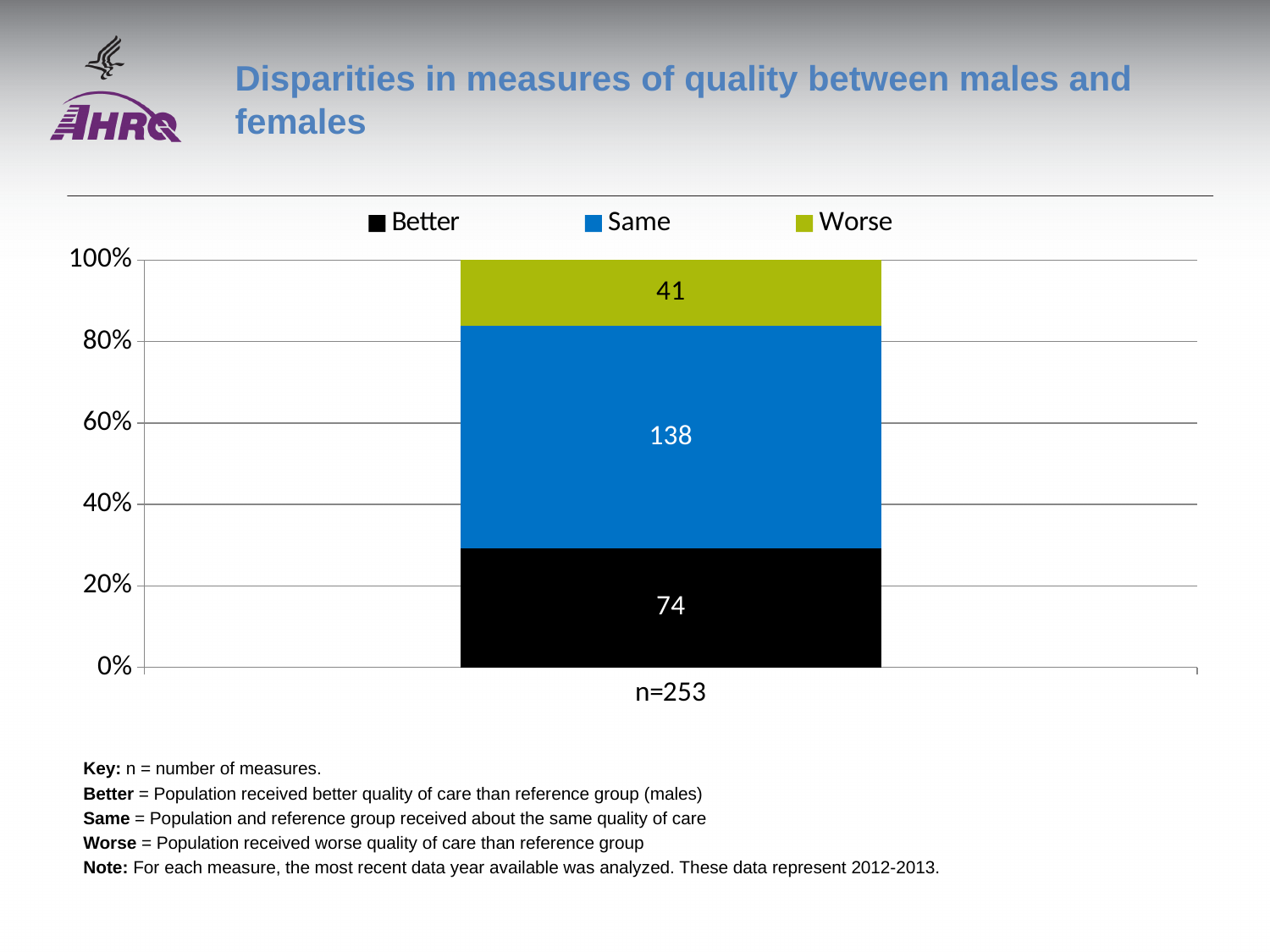
How many series does the legend list? 3 Which segment of the stacked bar has the smallest value? Worse What is the value of the Worse segment in the stacked bar? 41 What is the total of the three segments in the stacked bar? 253 What is the label on the x axis under the bar? n=253 What is the difference between the Same and Better values? 64 What is the value of the Same segment in the stacked bar? 138 What is the difference between the Better and Worse values? 33 Which segment of the stacked bar has the largest value? Same What is the value of the Better segment in the stacked bar? 74 Which is larger, the Better value or the Worse value? Better What kind of chart is shown on the slide? Stacked bar chart